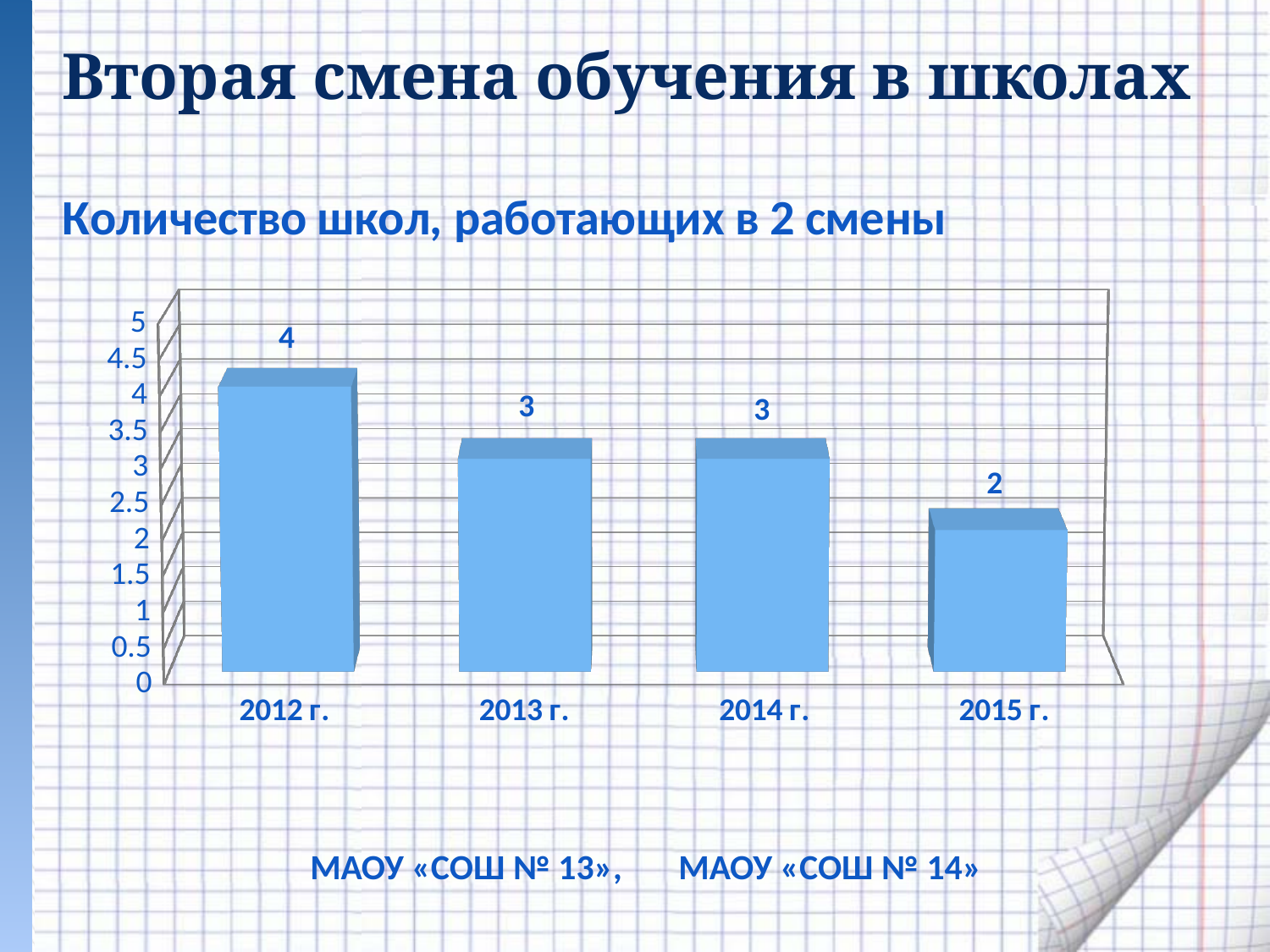
What is the title of the chart? Количество школ, работающих в 2 смены Which is larger, the value for 2014 г. or the value for 2015 г.? 2014 г. Do the values rise or fall from 2012 г. to 2015 г.? fall Which year has the highest value? 2012 г. What is the value for 2012 г.? 4 What kind of chart is shown on the slide? bar chart What is the difference between the values for 2012 г. and 2015 г.? 2 Is the value for 2012 г. greater or less than 3.5? greater How many years are shown on the x axis? 4 What is the value for 2013 г.? 3 Which year has the lowest value? 2015 г. What is the value for 2015 г.? 2